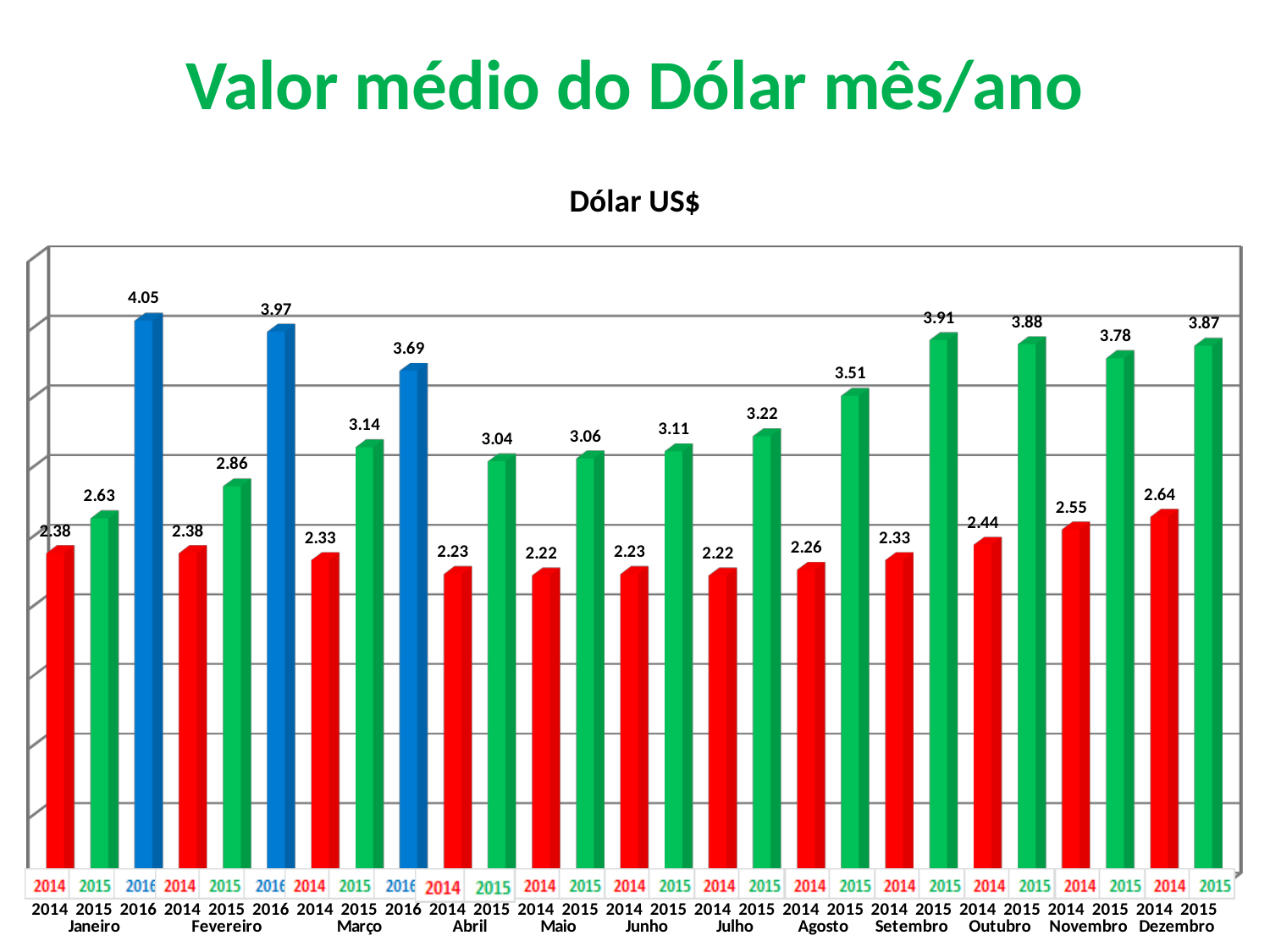
What is the difference between the 2015 and 2014 values for Dezembro? 1.23 How many months have a bar for 2016? 3 What is the value for 2014 in Novembro? 2.55 Which bar has the highest value in the chart? Janeiro 2016 (4.05) What kind of chart is shown on the slide? Bar chart How many months are shown on the x axis? 12 What is the difference between the 2016 and 2015 values for Janeiro? 1.42 Which is larger, the 2016 value for Fevereiro or the 2016 value for Março? Fevereiro (3.97) Among the 2015 bars, which month has the lowest value? Janeiro (2.63) What is the value for 2016 in Janeiro? 4.05 Do the 2015 values rise or fall from Abril to Setembro? Rise What is the value for 2015 in Setembro? 3.91